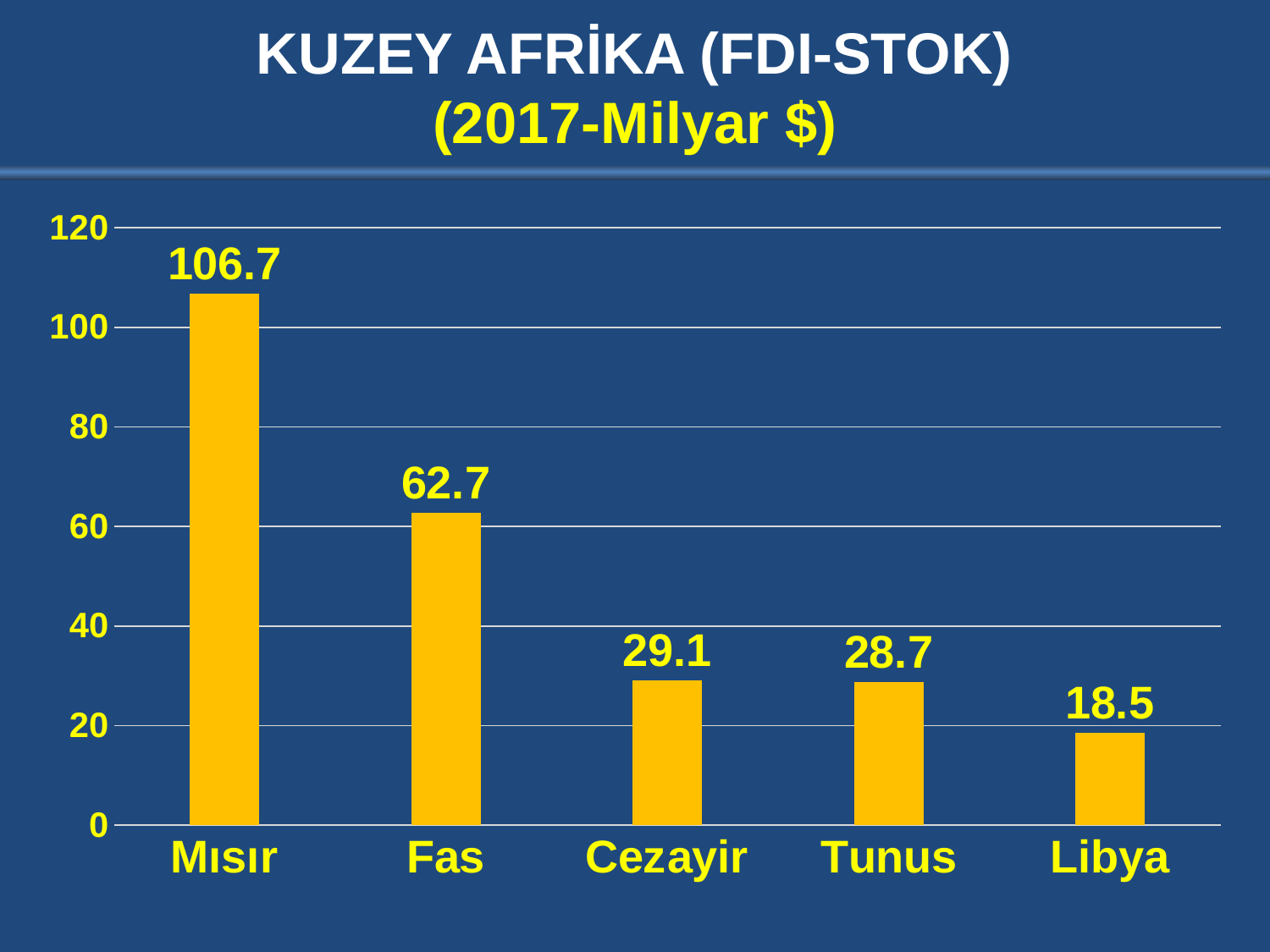
What is the value shown for Fas? 62.7 Which country has the highest FDI stock on the chart? Mısır Is the value for Tunus greater or less than 40? less What kind of chart is shown on the slide? bar chart What is the FDI stock value for Mısır? 106.7 What is the value shown for Libya? 18.5 What is the difference between the values for Mısır and Fas? 44 What is the difference between the values for Cezayir and Tunus? 0.4 How many countries are shown on the chart? 5 What is the title of the chart? KUZEY AFRİKA (FDI-STOK) (2017-Milyar $) Which has a larger value, Fas or Cezayir? Fas Which country has the lowest FDI stock on the chart? Libya